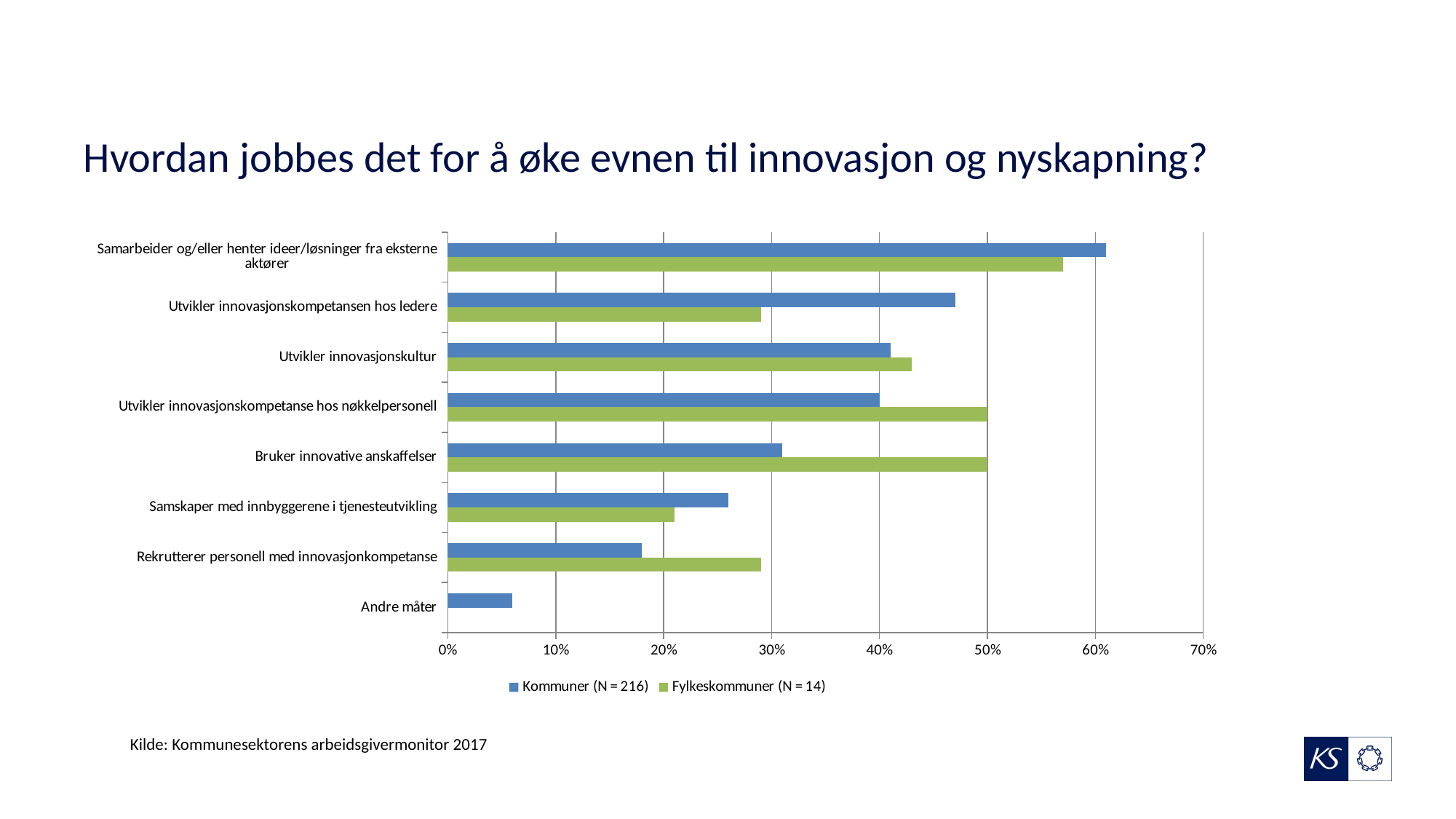
What kind of chart is shown on the slide? bar chart For 'Utvikler innovasjonskompetansen hos ledere', which series has the larger value, Kommuner or Fylkeskommuner? Kommuner Is the Kommuner value for 'Samarbeider og/eller henter ideer/løsninger fra eksterne aktører' greater or less than 50%? greater Which category has the lowest value for Kommuner (N = 216)? Andre måter What are the two series named in the legend? Kommuner (N = 216) and Fylkeskommuner (N = 14) Which category has the highest value for Kommuner (N = 216)? Samarbeider og/eller henter ideer/løsninger fra eksterne aktører How many series does the legend list? 2 For 'Bruker innovative anskaffelser', which series has the larger value, Kommuner or Fylkeskommuner? Fylkeskommuner Is the Fylkeskommuner value for 'Utvikler innovasjonskompetansen hos ledere' greater or less than 40%? less Is the Kommuner value for 'Andre måter' greater or less than 10%? less How many categories are shown on the chart? 8 Which category has the highest value for Fylkeskommuner (N = 14)? Samarbeider og/eller henter ideer/løsninger fra eksterne aktører